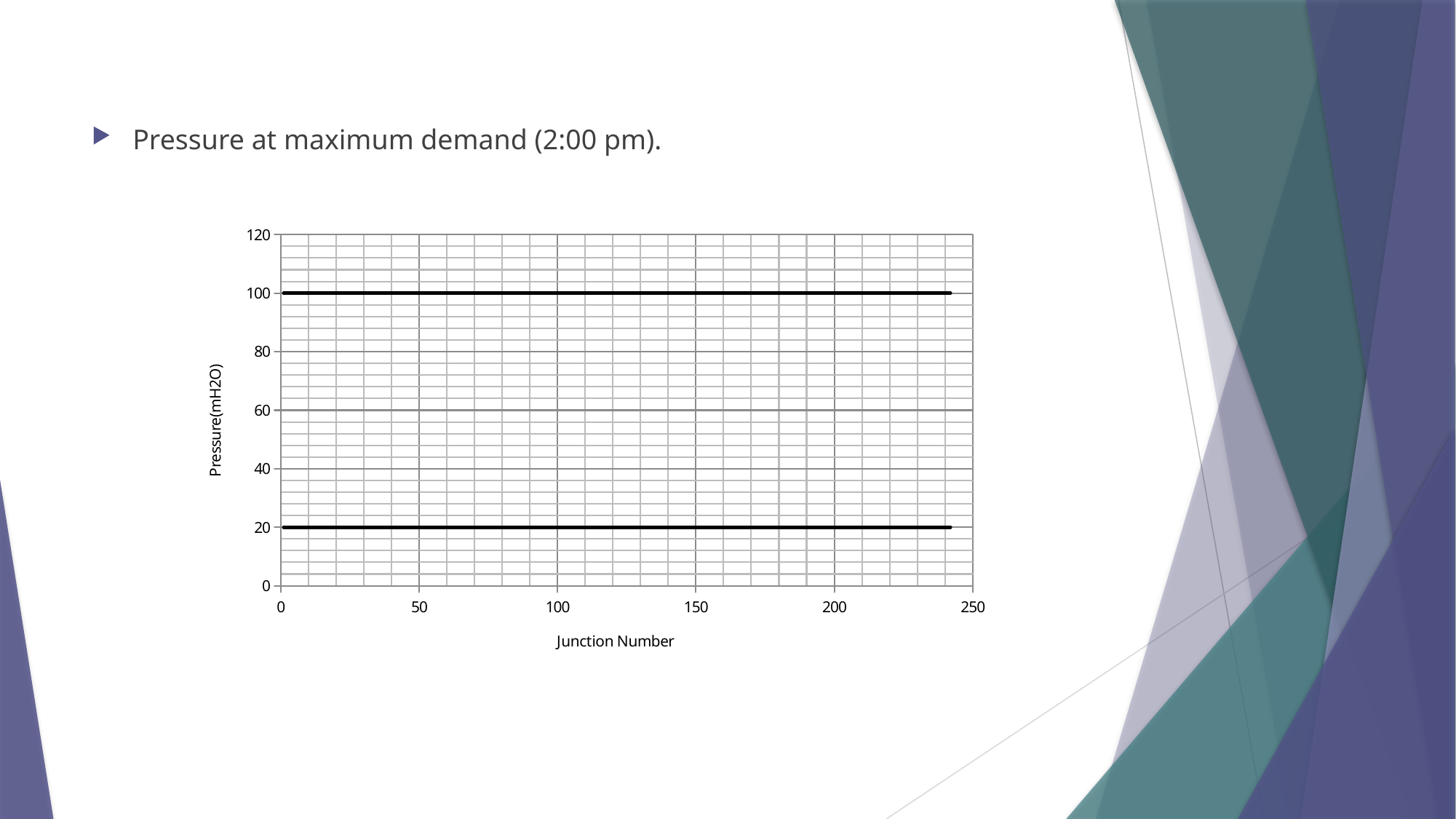
What is the label of the horizontal axis? Junction Number At what pressure value does the lower line sit? 20 What is the highest value shown on the vertical axis? 120 Is the value of the lower line greater or less than 40? less What kind of chart is shown on the slide? line chart What is the label of the vertical axis? Pressure(mH2O) Do the plotted lines rise, fall, or stay flat as the junction number increases? stay flat How many horizontal lines are plotted on the chart? 2 At what pressure value does the upper line sit? 100 Which line has the higher pressure value, the upper line or the lower line? the upper line Is the value of the upper line greater or less than 80? greater What is the difference in pressure between the upper line and the lower line? 80